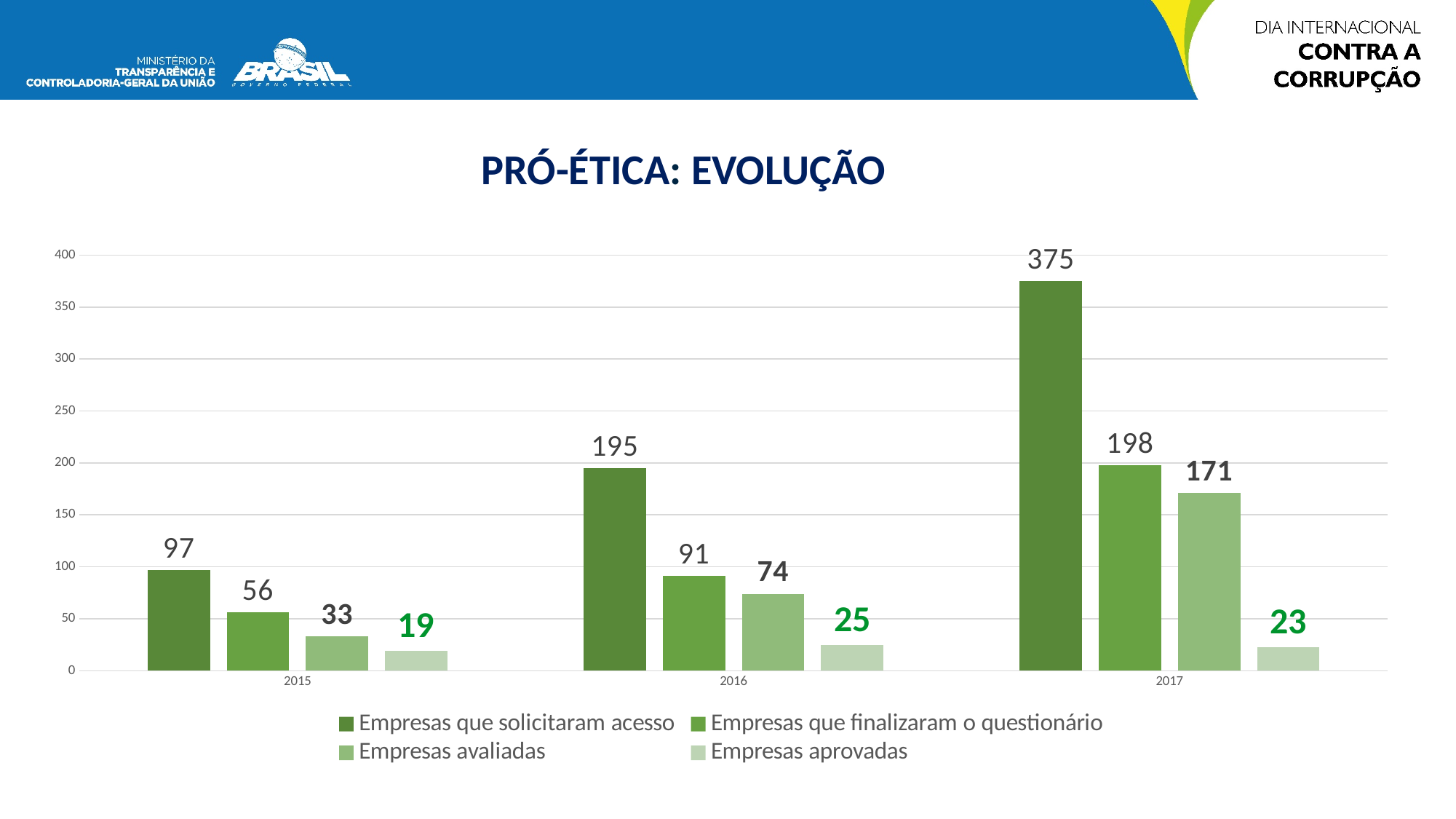
What is the value for Empresas avaliadas in 2016? 74 What kind of chart is shown on the slide? Bar chart What is the value for Empresas aprovadas in 2015? 19 In which year was the number of Empresas que finalizaram o questionário highest? 2017 Which is larger: Empresas avaliadas in 2017 or Empresas que finalizaram o questionário in 2016? Empresas avaliadas in 2017 In which year was the number of Empresas aprovadas lowest? 2015 How many years are shown on the x axis? 3 How many series does the legend list? 4 Does the number of Empresas que solicitaram acesso rise or fall from 2015 to 2017? Rise What is the difference between Empresas que solicitaram acesso in 2017 and in 2016? 180 Is the value for Empresas que solicitaram acesso in 2016 greater or less than 150? greater How many companies requested access (Empresas que solicitaram acesso) in 2017? 375